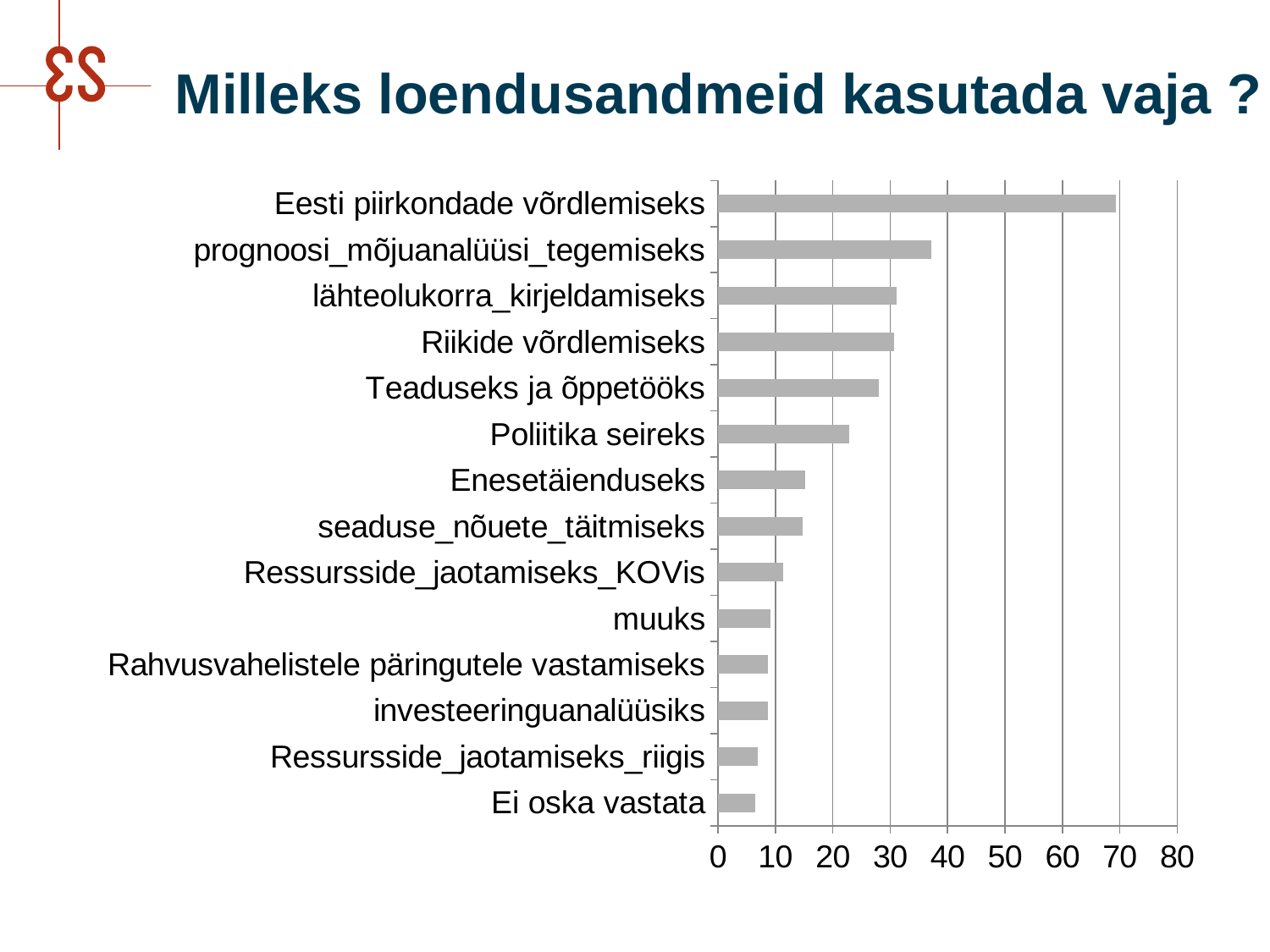
Is the value for prognoosi_mõjuanalüüsi_tegemiseks greater or less than 40? less Is the value for Ei oska vastata greater or less than 10? less What is the highest value shown on the horizontal axis of the chart? 80 How many categories are plotted in the chart? 14 Is the value for Teaduseks ja õppetööks greater or less than 30? less What is the title of the slide containing the chart? Milleks loendusandmeid kasutada vaja ? Which is larger, the value for Enesetäienduseks or the value for Poliitika seireks? Poliitika seireks Which category has the highest value in the chart? Eesti piirkondade võrdlemiseks What kind of chart is shown on the slide? bar chart Which is larger, the value for Ressursside_jaotamiseks_KOVis or the value for muuks? Ressursside_jaotamiseks_KOVis